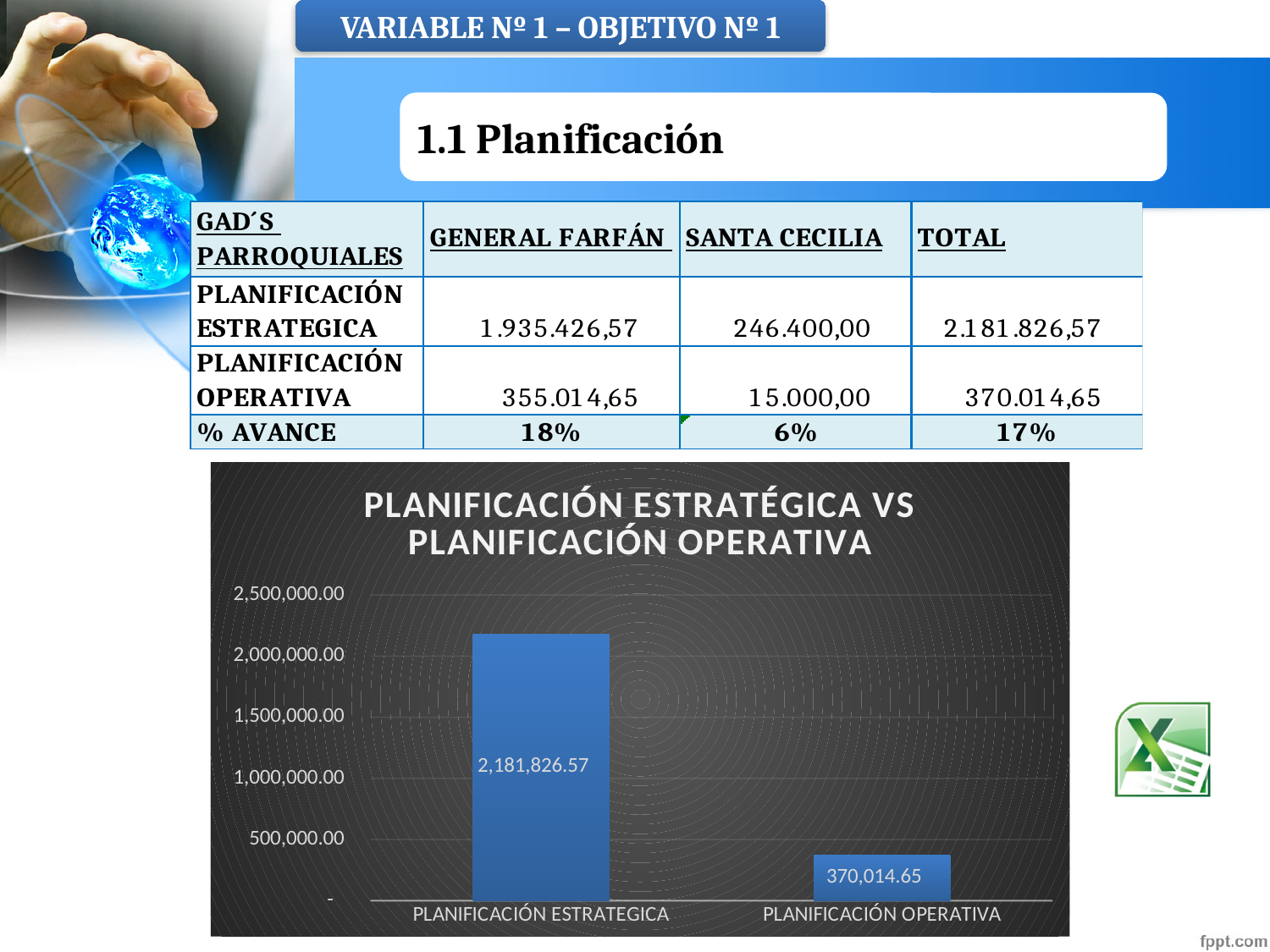
Is the value for PLANIFICACIÓN ESTRATEGICA greater or less than 2,000,000.00? greater What is the difference between the values for PLANIFICACIÓN ESTRATEGICA and PLANIFICACIÓN OPERATIVA in the chart? 1,811,811.92 Which is larger in the chart, PLANIFICACIÓN ESTRATEGICA or PLANIFICACIÓN OPERATIVA? PLANIFICACIÓN ESTRATEGICA How many categories are plotted in the chart? 2 What is the value shown for PLANIFICACIÓN OPERATIVA in the chart? 370,014.65 What is the value shown for PLANIFICACIÓN ESTRATEGICA in the chart? 2,181,826.57 Which category has the highest value in the chart? PLANIFICACIÓN ESTRATEGICA What is the title of the chart? PLANIFICACIÓN ESTRATÉGICA VS PLANIFICACIÓN OPERATIVA Do the values rise or fall from left to right along the x axis of the chart? fall Which category has the lowest value in the chart? PLANIFICACIÓN OPERATIVA What kind of chart is shown on the slide? bar chart Is the value for PLANIFICACIÓN OPERATIVA greater or less than 500,000.00? less